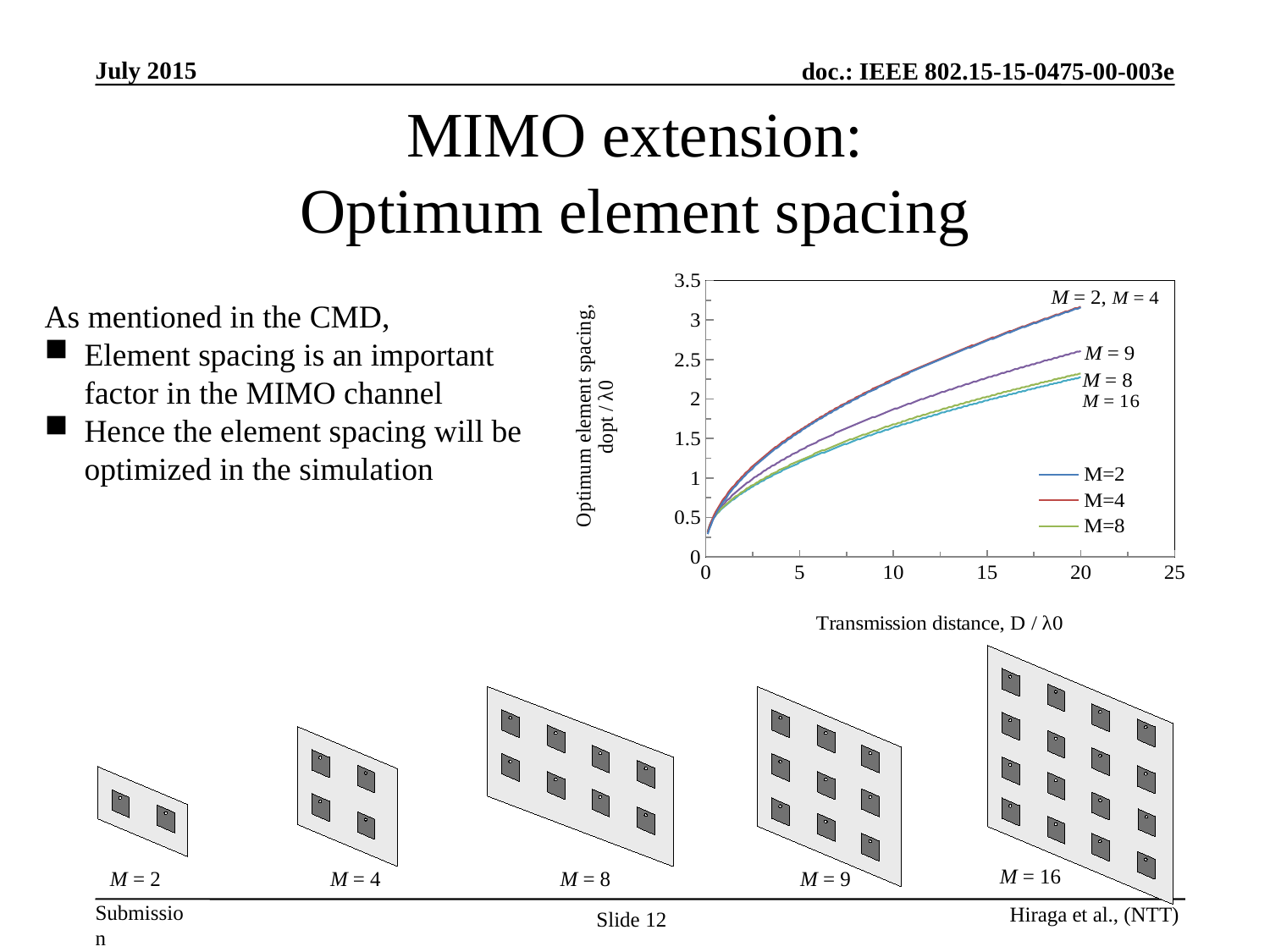
At a transmission distance of 20, which curve has the larger value, M=9 or M=8? M=9 Is the value of the M=16 curve at a transmission distance of 5 greater or less than 1.5? less What is the label of the chart's y axis? Optimum element spacing, dopt / λ0 Do the curves rise or fall as the transmission distance increases? rise Is the value of the M=8 curve at a transmission distance of 20 greater or less than 2.5? less What is the maximum value shown on the chart's y axis? 3.5 Is the value of the M=9 curve at a transmission distance of 10 greater or less than 1.5? greater What kind of chart is shown on the slide? line chart How many series does the chart's legend list? 3 At a transmission distance of 15, which curve has the larger value, M=2 or M=16? M=2 What is the label of the chart's x axis? Transmission distance, D / λ0